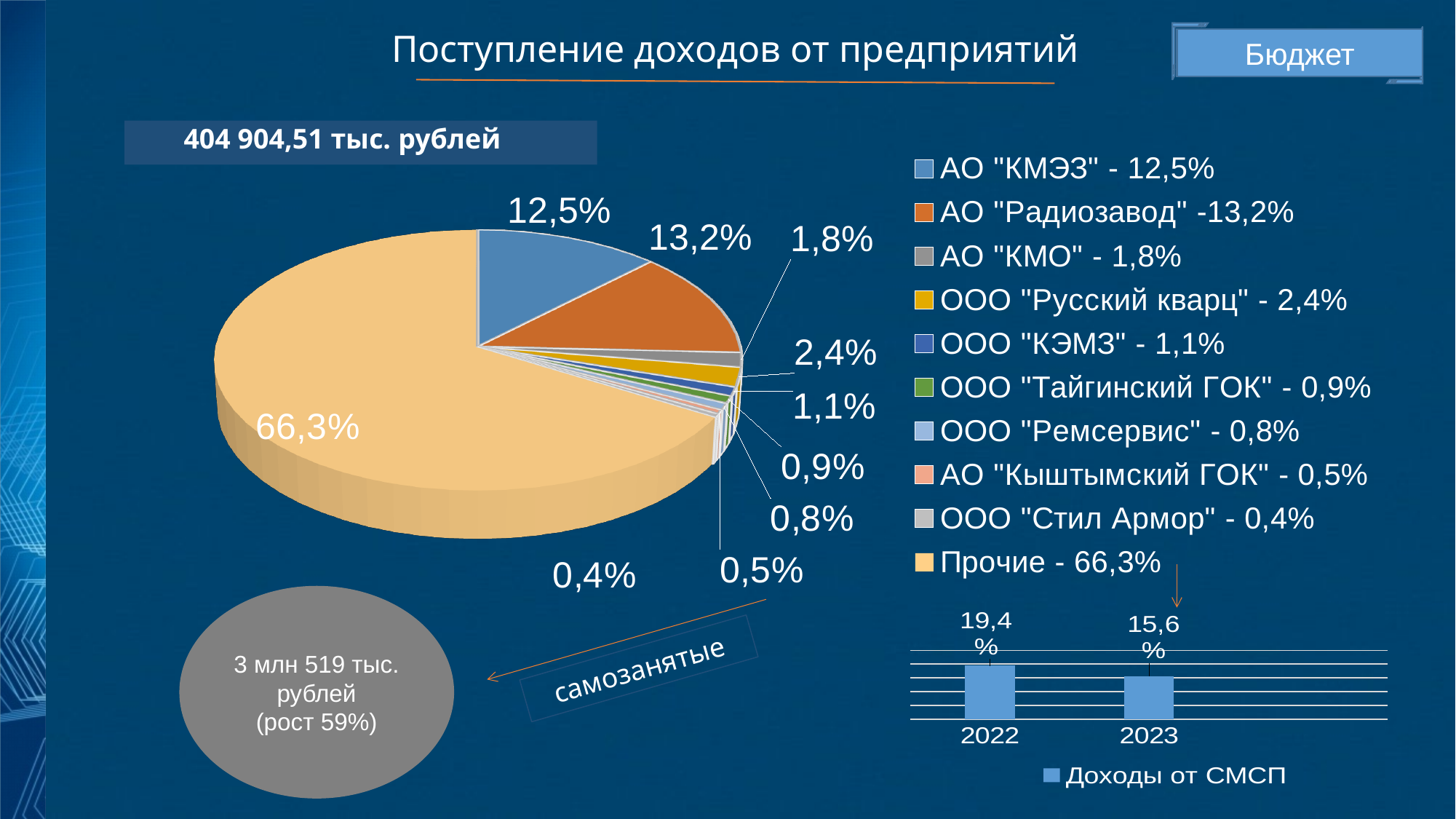
What type of chart is the large chart on the left of the slide? Pie chart On the pie chart, which is larger: the share of АО "КМЭЗ" or АО "Радиозавод"? АО "Радиозавод" On the pie chart, which category has the largest slice? Прочие On the pie chart, what is the difference between the shares of АО "Радиозавод" and АО "КМЭЗ"? 0,7% On the bar chart "Доходы от СМСП", do the values rise or fall from 2022 to 2023? Fall On the pie chart, what share does ООО "Русский кварц" have? 2,4% On the pie chart, which named enterprise has the smallest slice? ООО "Стил Армор" On the bar chart "Доходы от СМСП", what is the value for 2023? 15,6% On the bar chart "Доходы от СМСП", what is the difference between the 2022 and 2023 values? 3,8% How many slices does the pie chart have? 10 How many series does the legend of the bar chart "Доходы от СМСП" list? 1 On the pie chart, what share does АО "Радиозавод" have? 13,2%